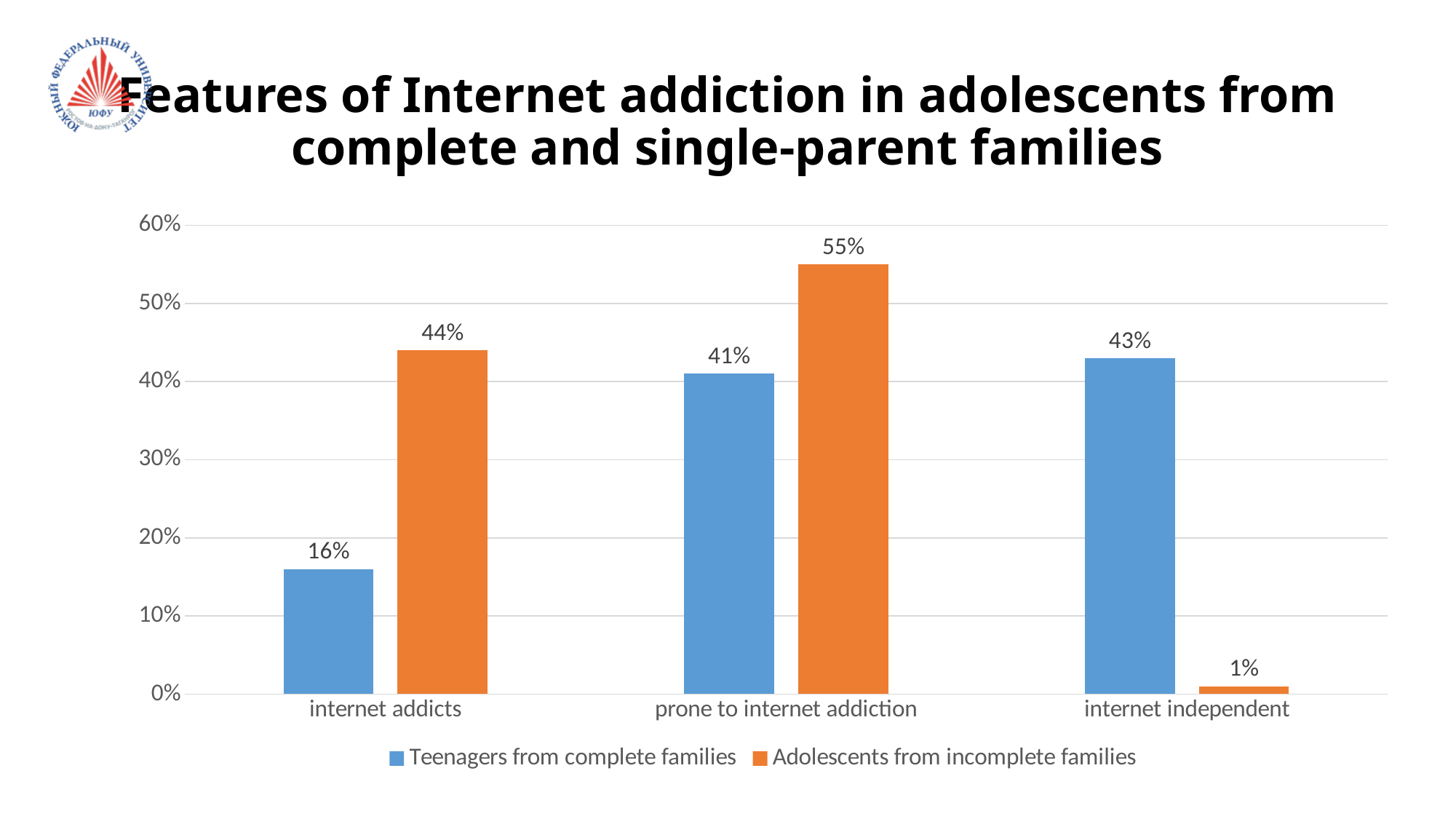
Which category has the lowest value for Adolescents from incomplete families? internet independent What is the value for Adolescents from incomplete families in the prone to internet addiction category? 55% What is the value for Teenagers from complete families in the internet addicts category? 16% Which category has the highest value for Teenagers from complete families? internet independent What colour represents Adolescents from incomplete families in the chart? orange In the prone to internet addiction category, which series has the larger value? Adolescents from incomplete families What kind of chart is shown on the slide? bar chart How many categories are shown on the x axis? 3 Is the value for Teenagers from complete families in the internet independent category greater or less than 40%? greater What is the difference between Adolescents from incomplete families and Teenagers from complete families in the internet addicts category? 28% How many series does the legend list? 2 What is the value for Adolescents from incomplete families in the internet independent category? 1%